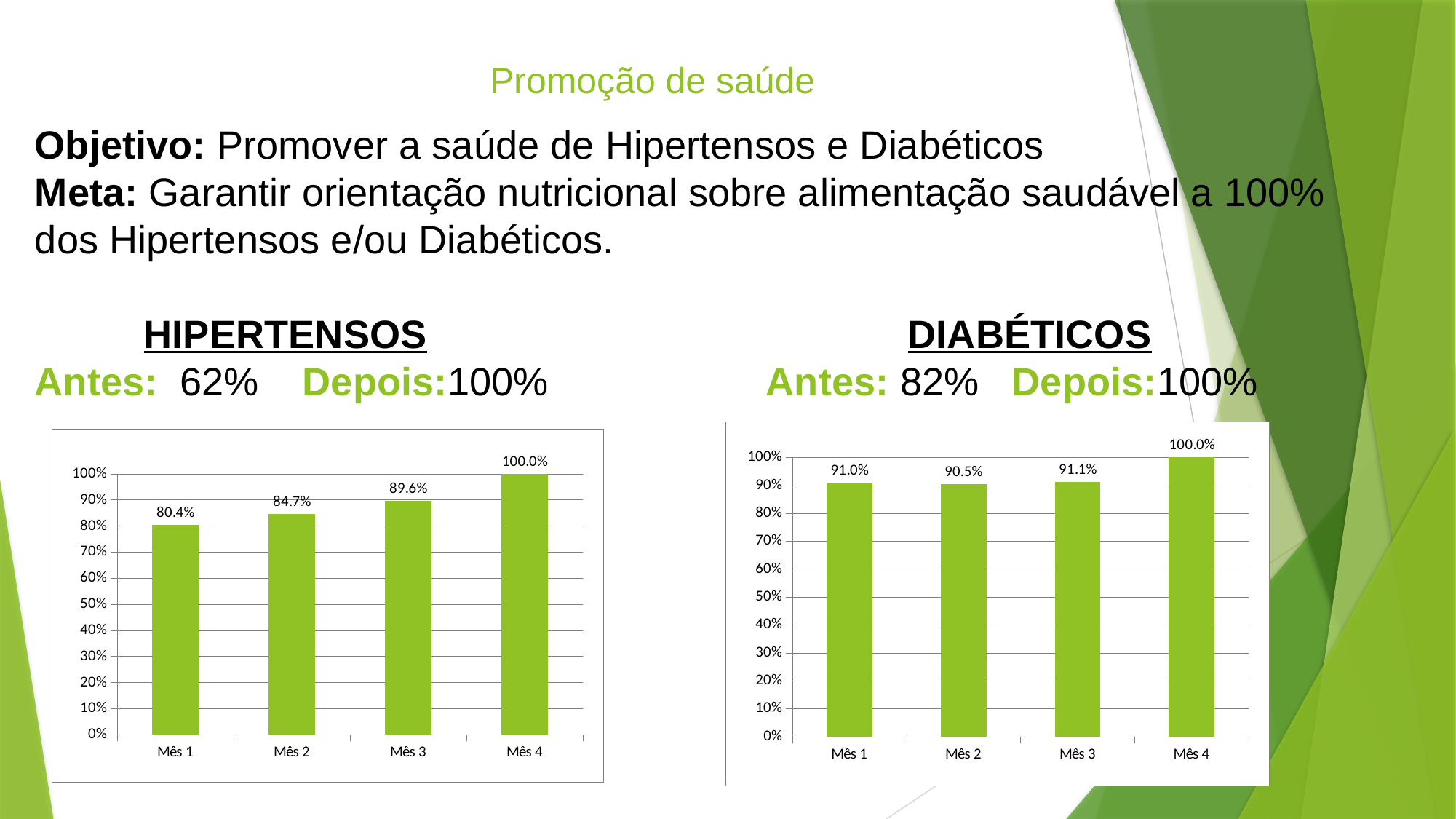
In the DIABÉTICOS chart (right), what is the difference between the values for Mês 4 and Mês 2? 9.5% In the HIPERTENSOS chart (left), what is the value for Mês 1? 80.4% In the HIPERTENSOS chart (left), which is larger, the value for Mês 2 or the value for Mês 3? Mês 3 In the HIPERTENSOS chart (left), which month has the lowest value? Mês 1 In the HIPERTENSOS chart (left), what is the value for Mês 3? 89.6% In the DIABÉTICOS chart (right), what is the value for Mês 4? 100.0% In the DIABÉTICOS chart (right), what is the value for Mês 2? 90.5% What kind of chart is the HIPERTENSOS chart (left)? bar chart In the HIPERTENSOS chart (left), what is the difference between the values for Mês 4 and Mês 1? 19.6% In the HIPERTENSOS chart (left), do the values rise or fall from Mês 1 to Mês 4? rise How many months are shown on the x axis of the DIABÉTICOS chart (right)? 4 In the DIABÉTICOS chart (right), which month has the highest value? Mês 4